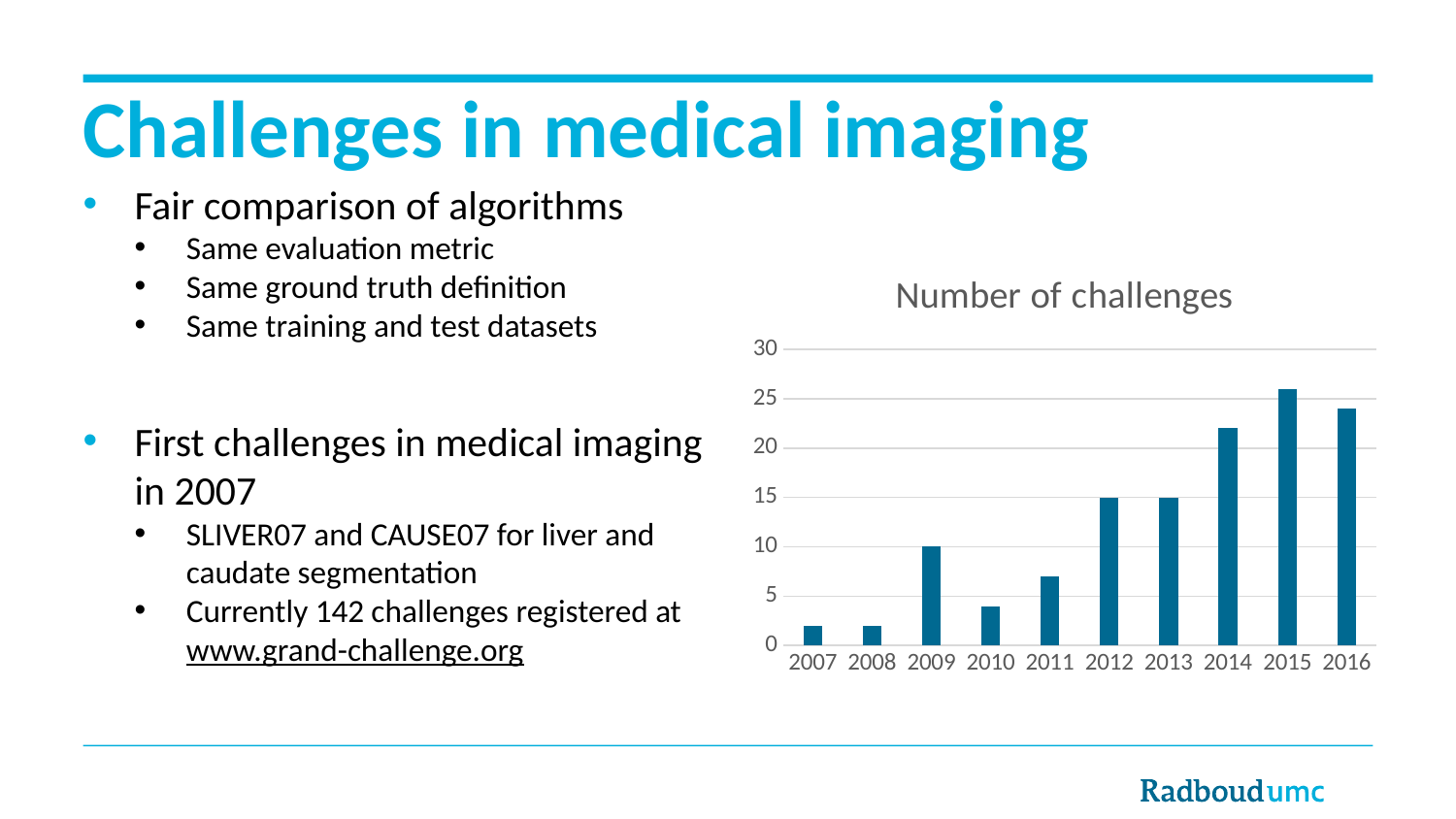
Is the value for 2010 greater or less than 5? less Is the value for 2011 greater or less than 5? greater What is the number of challenges in 2009? 10 Which year has the highest number of challenges? 2015 What is the title of the chart? Number of challenges Which year has more challenges, 2009 or 2010? 2009 What kind of chart is shown on the slide? bar chart Which year has more challenges, 2015 or 2016? 2015 Does the number of challenges generally rise or fall from 2007 to 2016? rise What is the number of challenges in 2012? 15 Is the value for 2014 greater or less than 20? greater How many years are shown on the x axis of the chart? 10